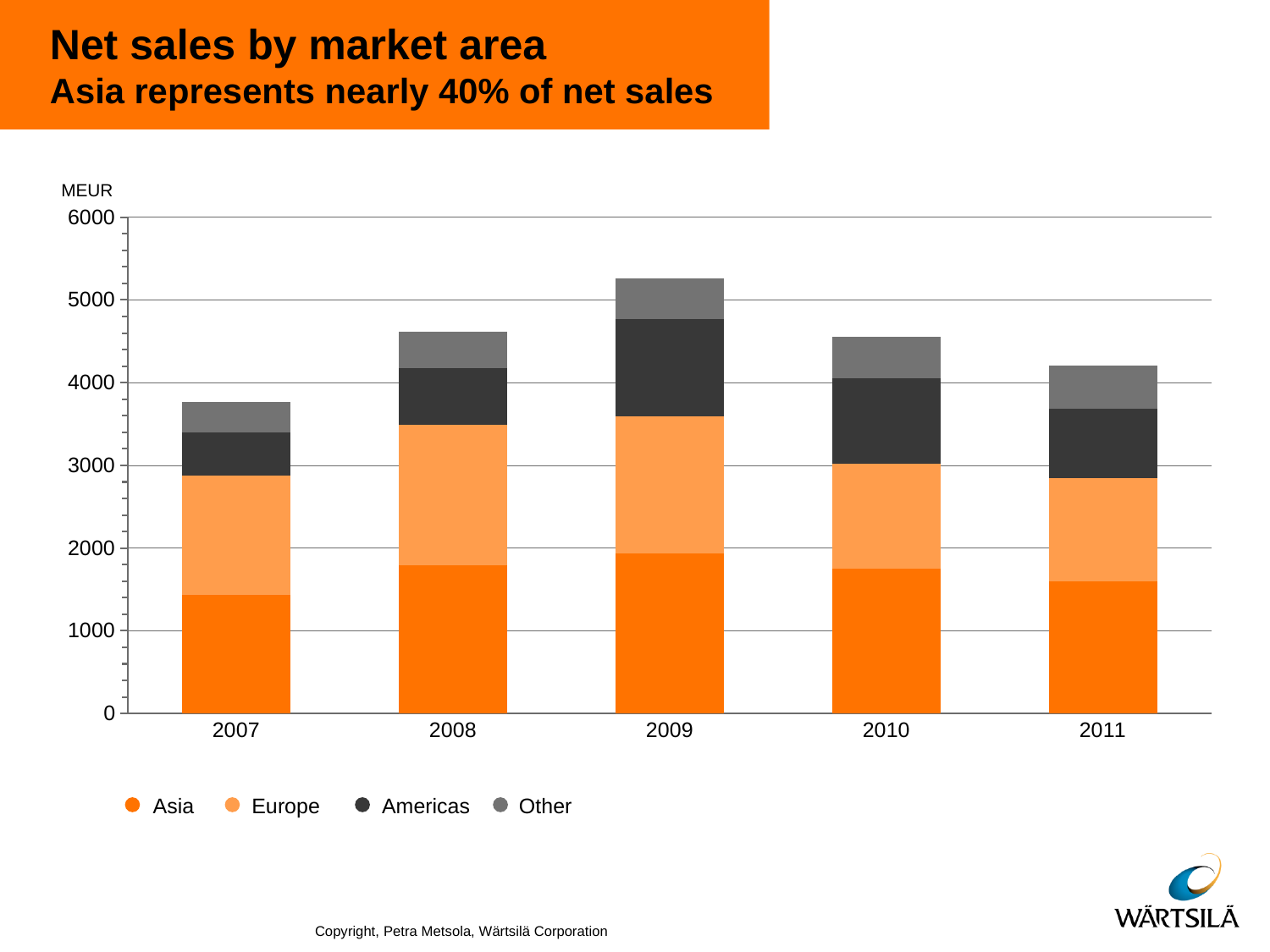
Which year has larger total net sales, 2009 or 2010? 2009 Which year has the highest total net sales? 2009 How many years are shown on the x axis of the chart? 5 Is the Asia value for 2007 greater or less than 1000? greater Is the total net sales for 2009 greater or less than 5000? greater Is the total net sales for 2007 greater or less than 4000? less Which year has the lowest total net sales? 2007 What unit is shown above the y axis of the chart? MEUR What kind of chart is shown on the slide? stacked bar chart How many series does the legend list? 4 Do total net sales rise or fall from 2009 to 2011? fall